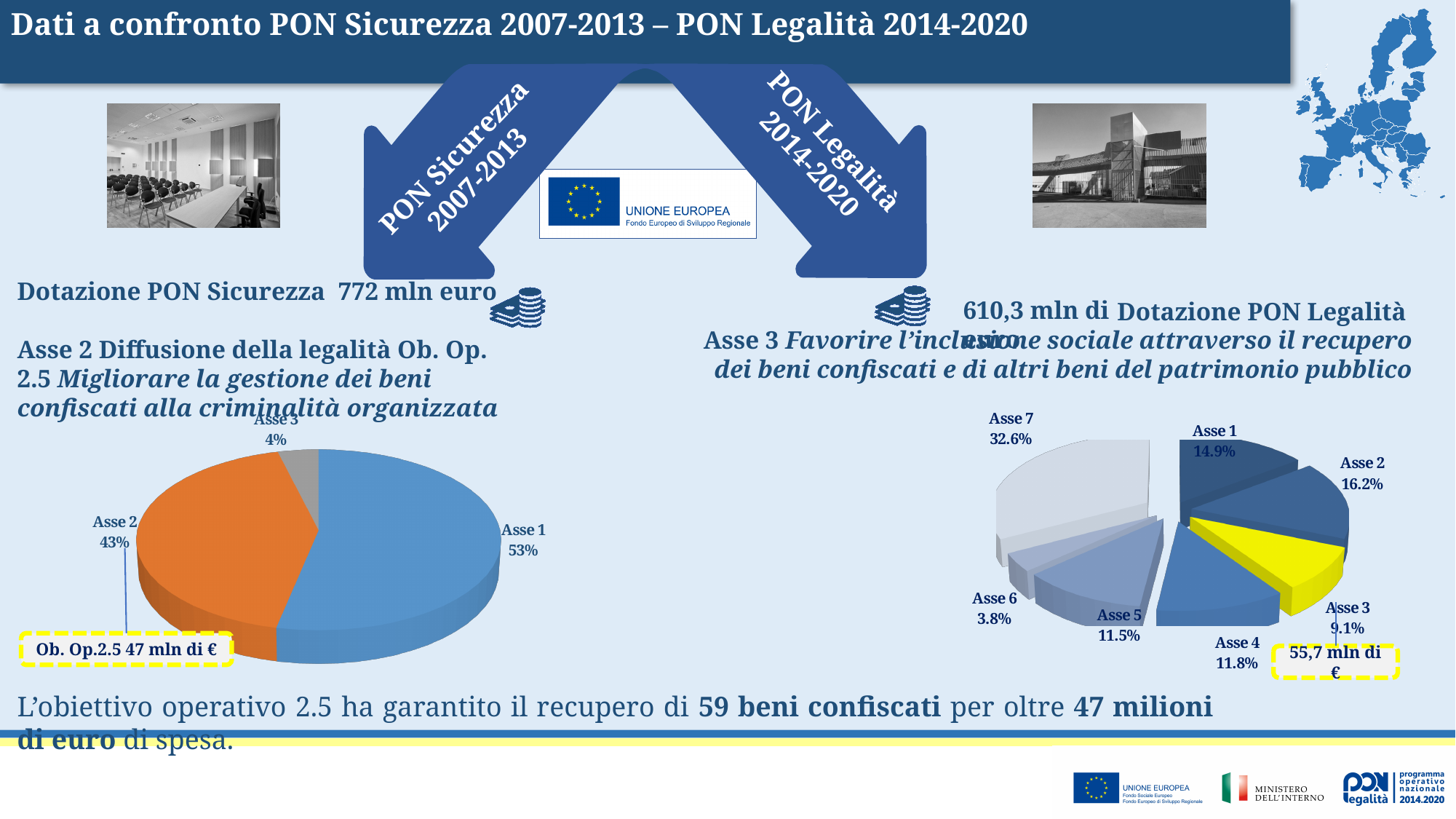
In the pie chart on the right of the slide, what share does Asse 7 have? 32.6% In the pie chart on the right of the slide, which Asse has the smallest share? Asse 6 In the pie chart on the left of the slide, which Asse has the largest share? Asse 1 In the pie chart on the left of the slide, what share does Asse 1 have? 53% How many slices does the pie chart on the left of the slide have? 3 How many slices does the pie chart on the right of the slide have? 7 What type of chart is shown on the right of the slide? Pie chart In the pie chart on the left of the slide, what is the difference between the shares of Asse 1 and Asse 2? 10% In the pie chart on the right of the slide, which has the larger share, Asse 2 or Asse 3? Asse 2 In the pie chart on the right of the slide, which Asse has the largest share? Asse 7 In the pie chart on the left of the slide, what share does Asse 3 have? 4% In the pie chart on the right of the slide, what share does Asse 4 have? 11.8%